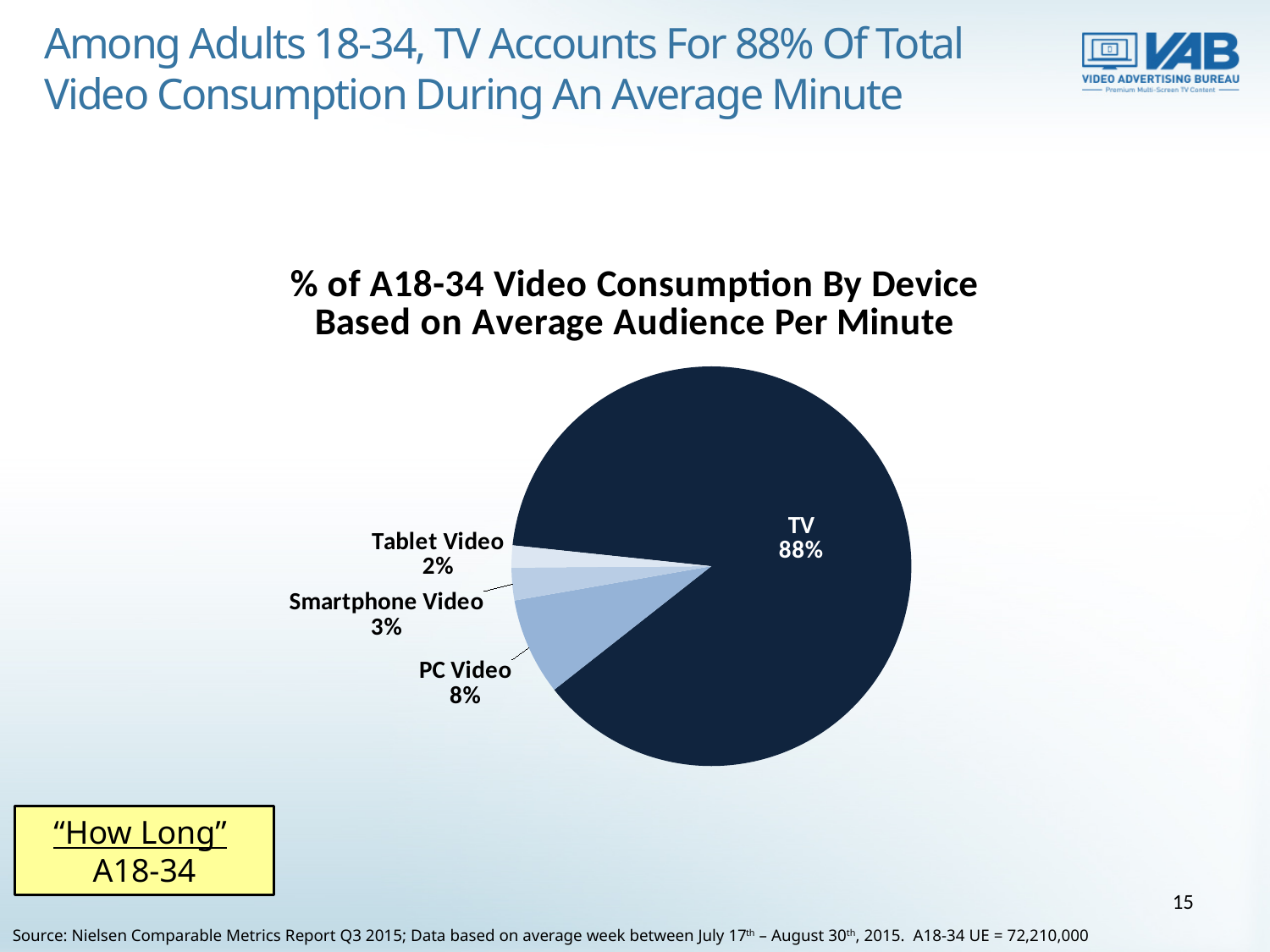
What type of chart is shown on the slide? Pie chart Which device has the smallest share of the pie chart? Tablet Video What is the difference in percentage points between TV and PC Video? 80 How many device categories are shown in the pie chart? 4 What share of A18-34 video consumption does TV account for in the pie chart? 88% What is the value shown for Smartphone Video? 3% What is the title of the chart? % of A18-34 Video Consumption By Device Based on Average Audience Per Minute What is the difference in percentage points between PC Video and Smartphone Video? 5 What is the value shown for Tablet Video? 2% Which device has the largest share of the pie chart? TV Which has a larger share, Smartphone Video or Tablet Video? Smartphone Video What percentage of the pie chart is PC Video? 8%